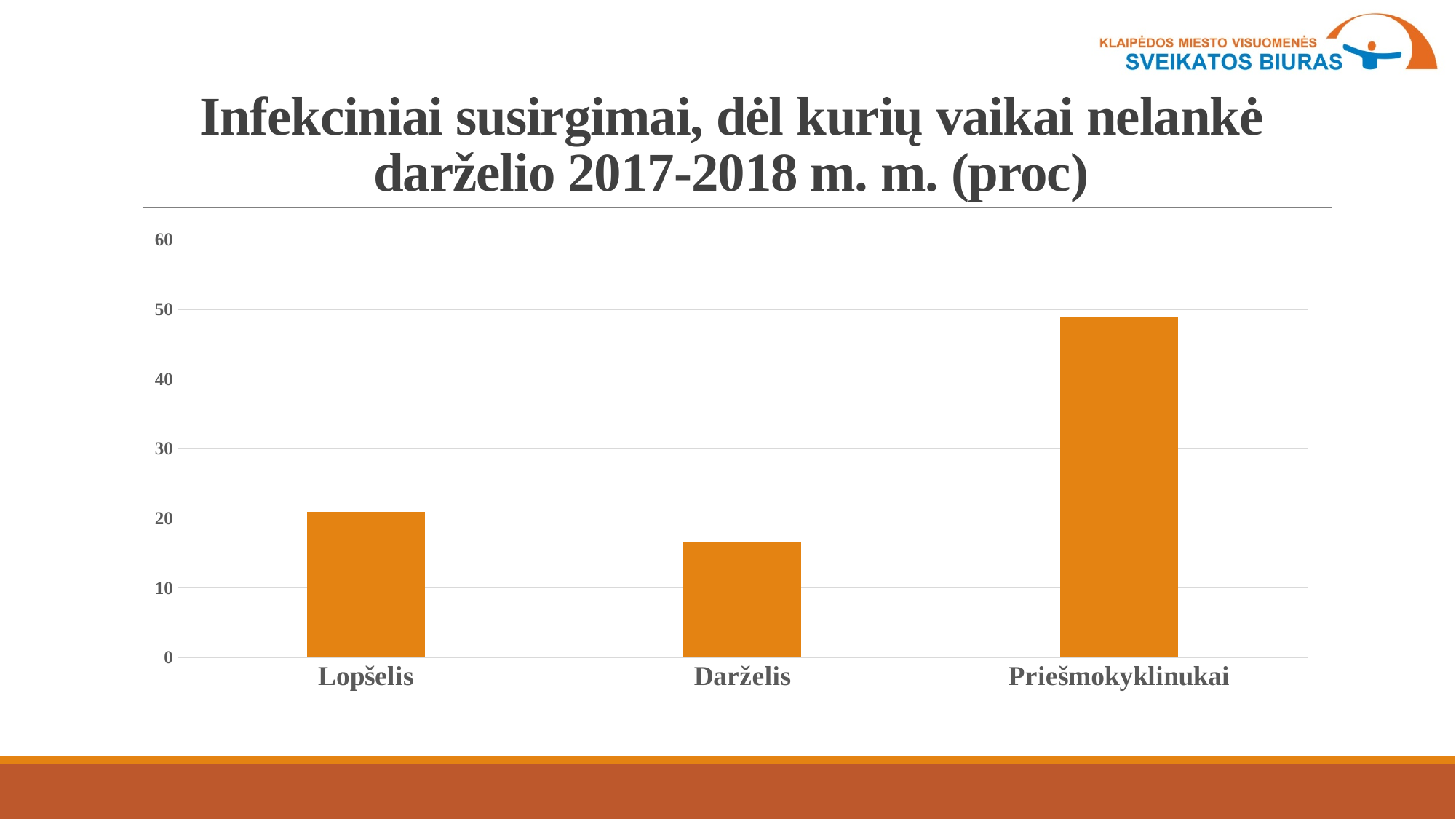
Is the value for Lopšelis greater or less than 30? less What kind of chart is shown on the slide? bar chart Which is larger, the value for Darželis or the value for Priešmokyklinukai? Priešmokyklinukai How many categories are shown on the x axis of the chart? 3 Is the value for Priešmokyklinukai greater or less than 40? greater What colour are the bars in the chart? orange What is the title of the chart on the slide? Infekciniai susirgimai, dėl kurių vaikai nelankė darželio 2017-2018 m. m. (proc) Which category has the highest value in the chart? Priešmokyklinukai Which category has the lowest value in the chart? Darželis Is the value for Darželis greater or less than 10? greater Which is larger, the value for Lopšelis or the value for Darželis? Lopšelis